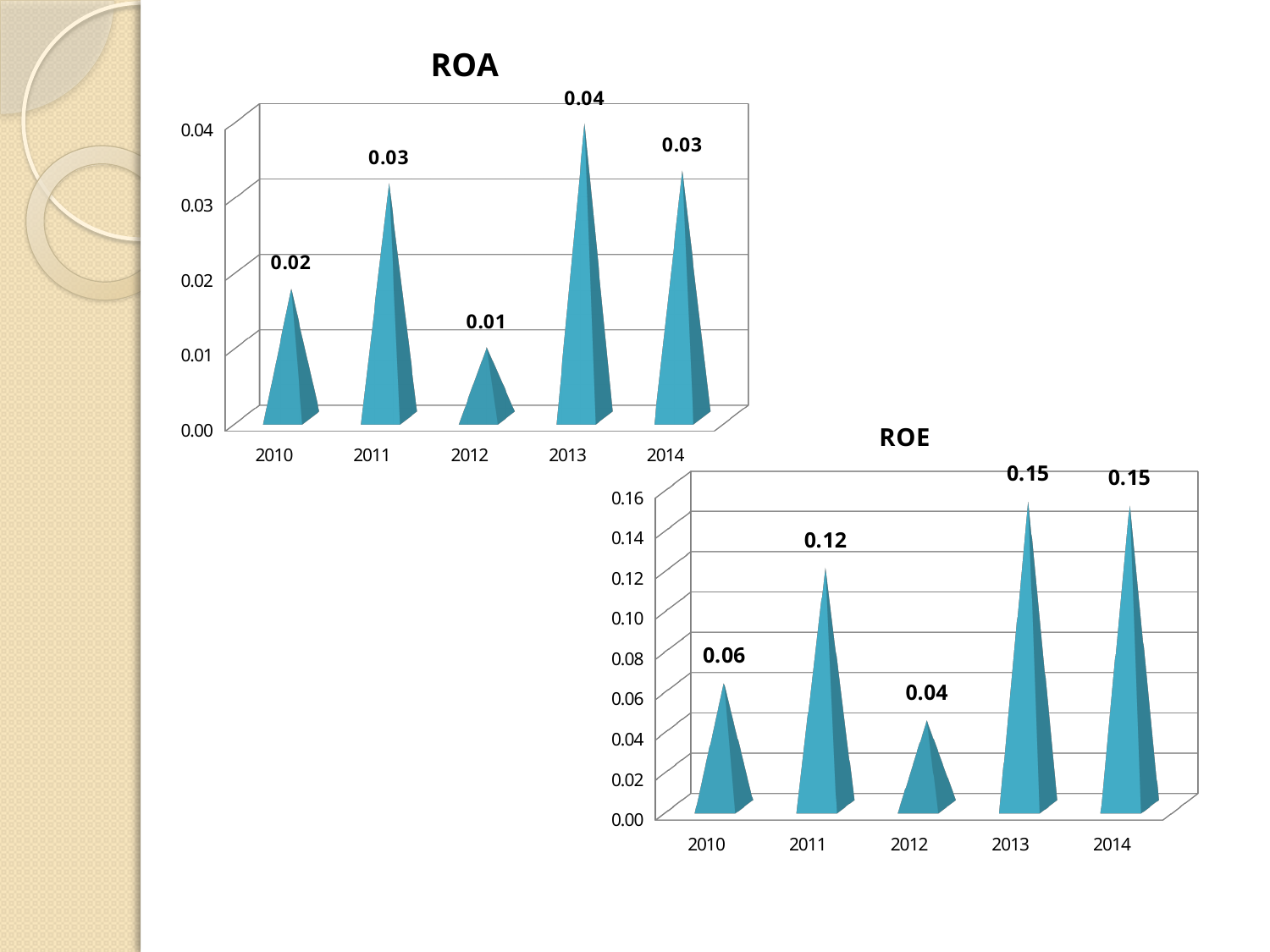
In the ROE chart, what is the value for 2010? 0.06 In the ROE chart, is the value for 2011 larger or smaller than the value for 2010? larger In the ROA chart, what is the value for 2013? 0.04 In the ROA chart, what is the difference between the values for 2013 and 2010? 0.02 In the ROE chart, what is the value for 2011? 0.12 What kind of chart is the ROE chart? bar chart In the ROA chart, which year has the lowest value? 2012 In the ROE chart, what is the difference between the values for 2011 and 2012? 0.08 In the ROA chart, which year has the highest value? 2013 In the ROA chart, what is the value for 2012? 0.01 In the ROE chart, which year has the lowest value? 2012 In the ROA chart, how many years are shown on the x axis? 5